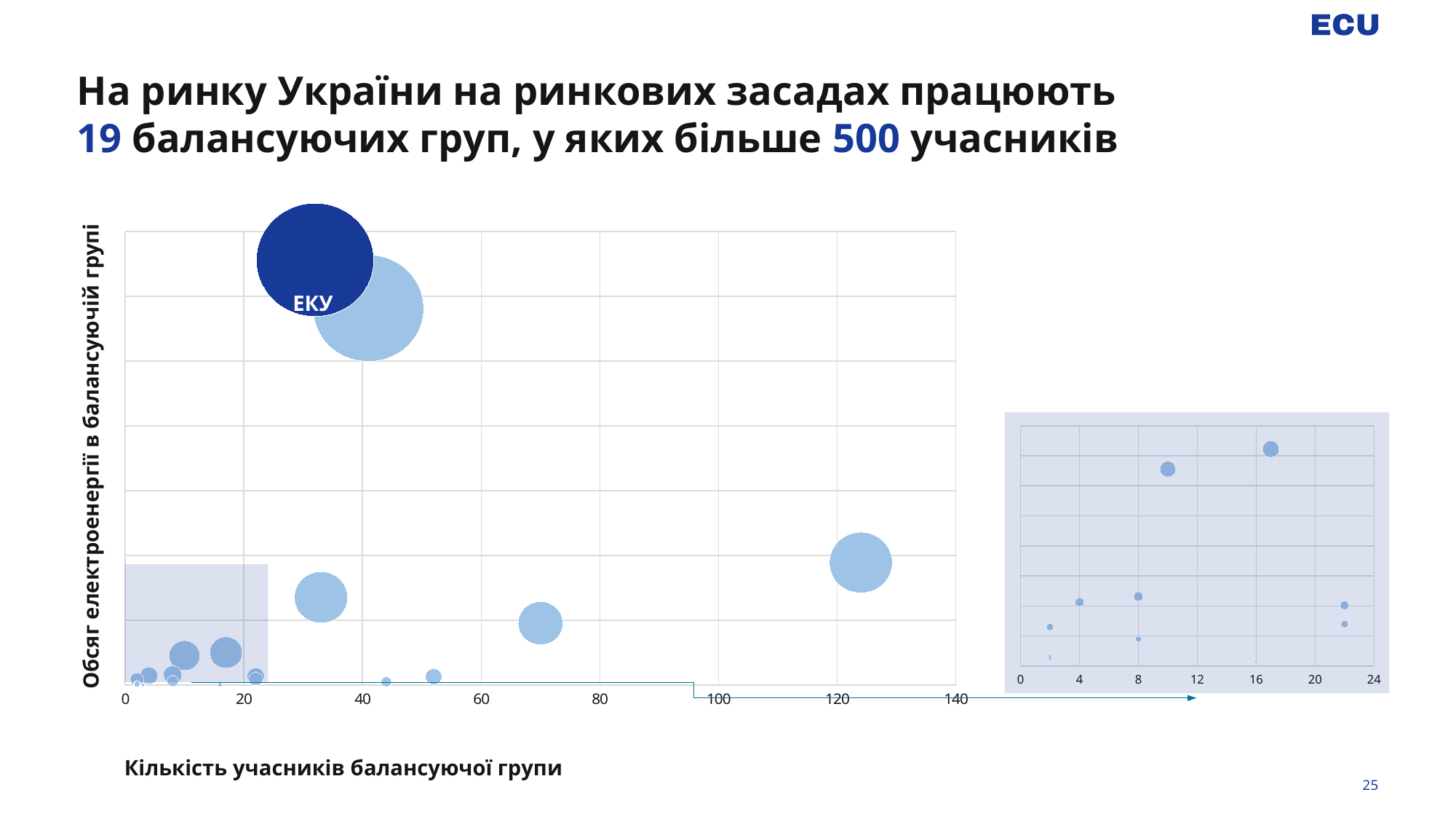
Is the x-axis value (number of participants) for the ЕКУ bubble greater or less than 20? greater What is the highest tick value shown on the x axis of the inset chart on the right? 24 How many balancing groups does the slide title say operate on the market? 19 Which labelled bubble sits highest on the y axis of the main chart? ЕКУ Is the x-axis value (number of participants) for the ЕКУ bubble greater or less than 40? less What is the label of the x axis of the main chart? Кількість учасників балансуючої групи What kind of chart is shown on the slide? Bubble chart What is the highest tick value shown on the x axis of the main chart? 140 Which bubble on the main chart is labelled? ЕКУ What is the label of the y axis of the main chart? Обсяг електроенергії в балансуючій групі Is the ЕКУ bubble darker or lighter in colour than the other bubbles? darker Is the rightmost bubble on the main chart at an x value greater or less than 100? greater